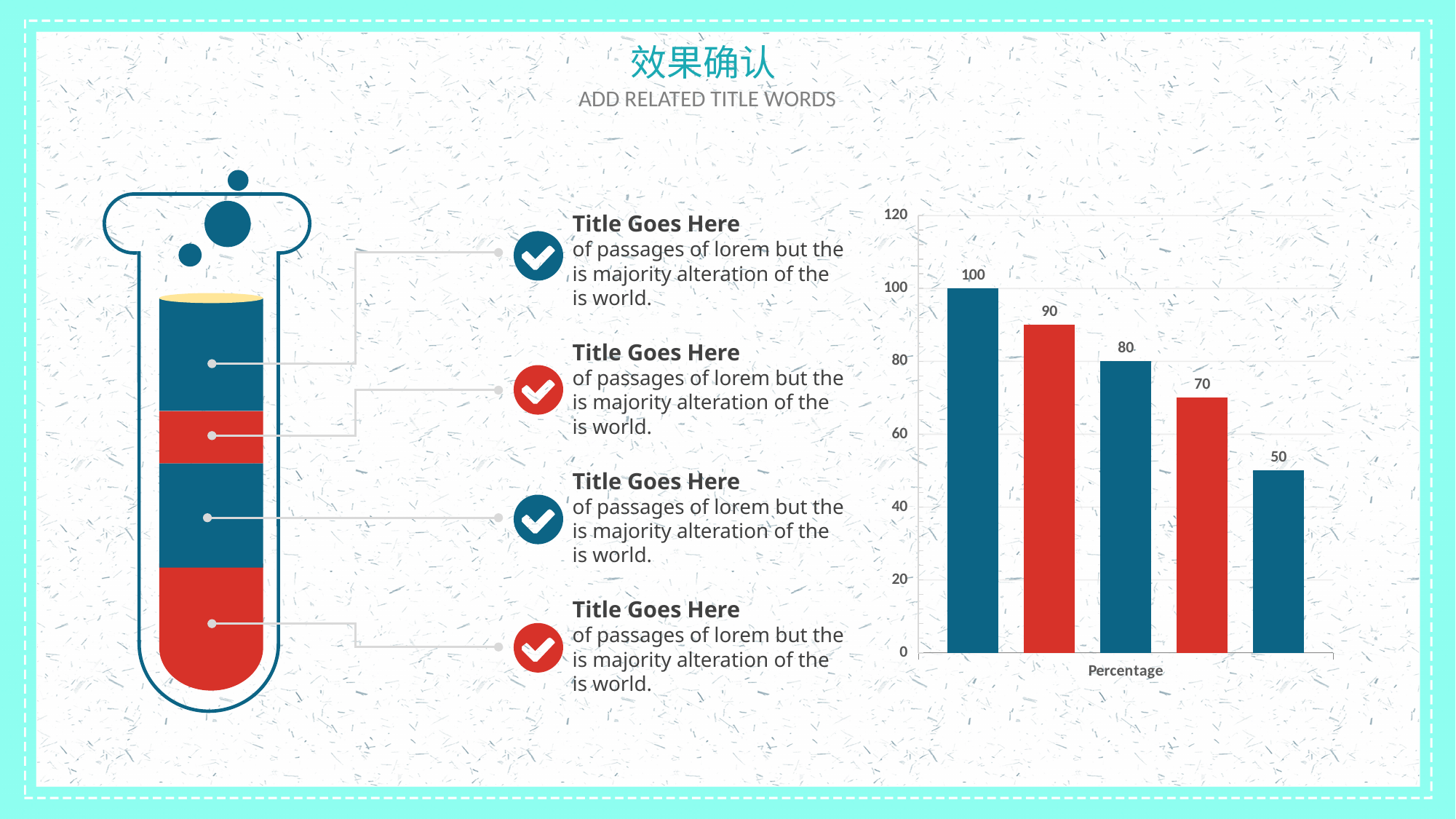
What is the value of the rightmost bar in the chart? 50 What is the difference between the fourth bar (70) and the fifth bar (50)? 20 What is the category label shown on the x axis of the chart? Percentage What kind of chart is shown on the right side of the slide? bar chart What is the value of the first (leftmost) bar in the chart? 100 What is the difference between the tallest bar and the shortest bar in the chart? 50 What is the lowest value shown in the chart? 50 What is the maximum value shown on the chart's vertical axis? 120 What is the value of the second bar from the left in the chart? 90 What is the highest value shown in the chart? 100 Do the bar values rise or fall from left to right across the chart? fall How many bars are plotted in the chart? 5